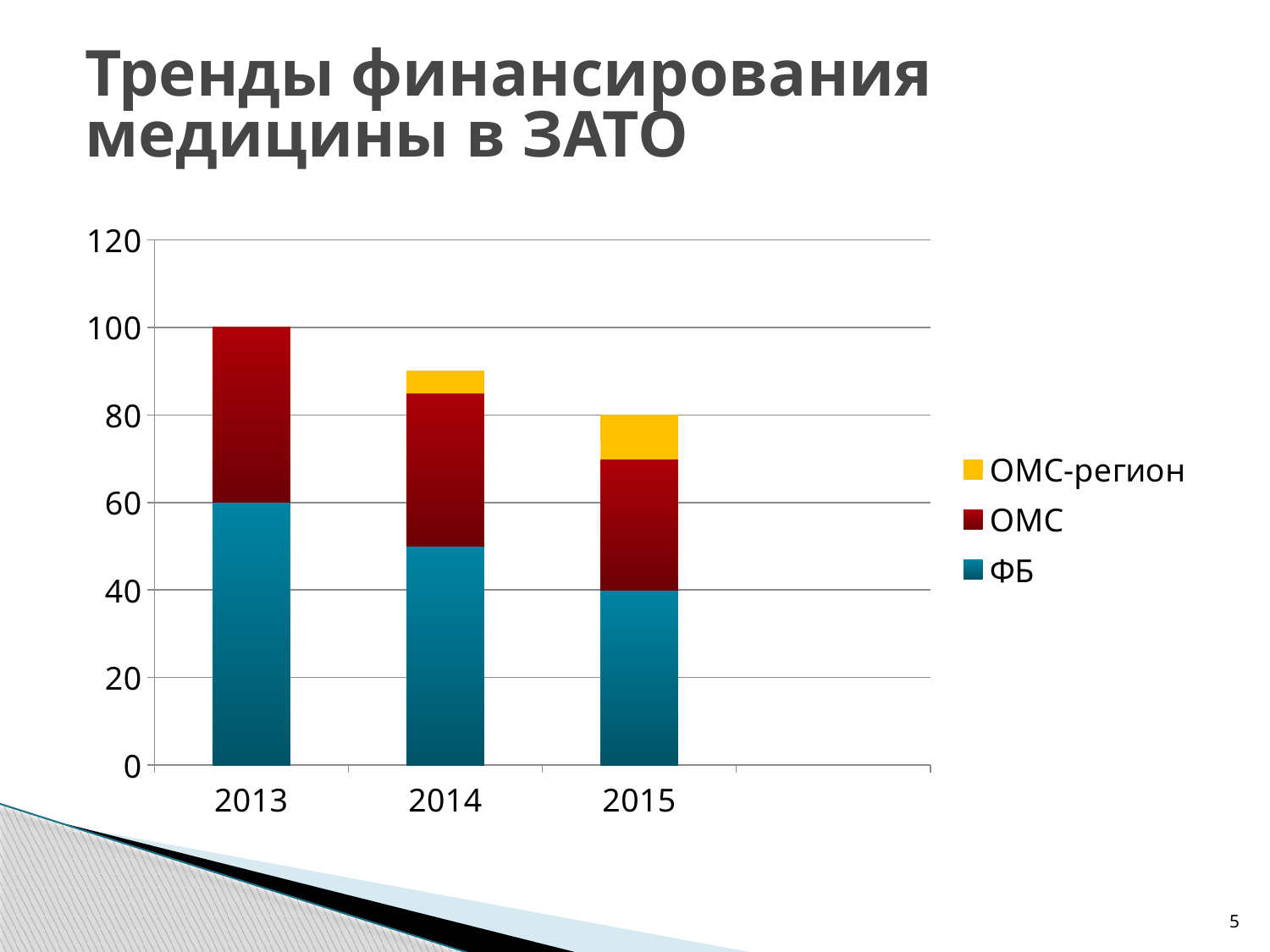
Which year has the highest total stacked bar? 2013 Is the ФБ segment for 2014 greater or less than 60? less How many years are shown on the x axis of the chart? 3 What is the value of the ФБ segment for 2015? 40 What kind of chart is shown on the slide? Stacked bar chart Which year has the lowest total stacked bar? 2015 Do the total stacked bar heights rise or fall from 2013 to 2015? fall What is the value of the ФБ segment for 2013? 60 Is the total height of the stacked bar for 2014 greater or less than 80? greater How many series does the chart legend list? 3 What is the total height of the stacked bar for 2013? 100 What is the total height of the stacked bar for 2015? 80